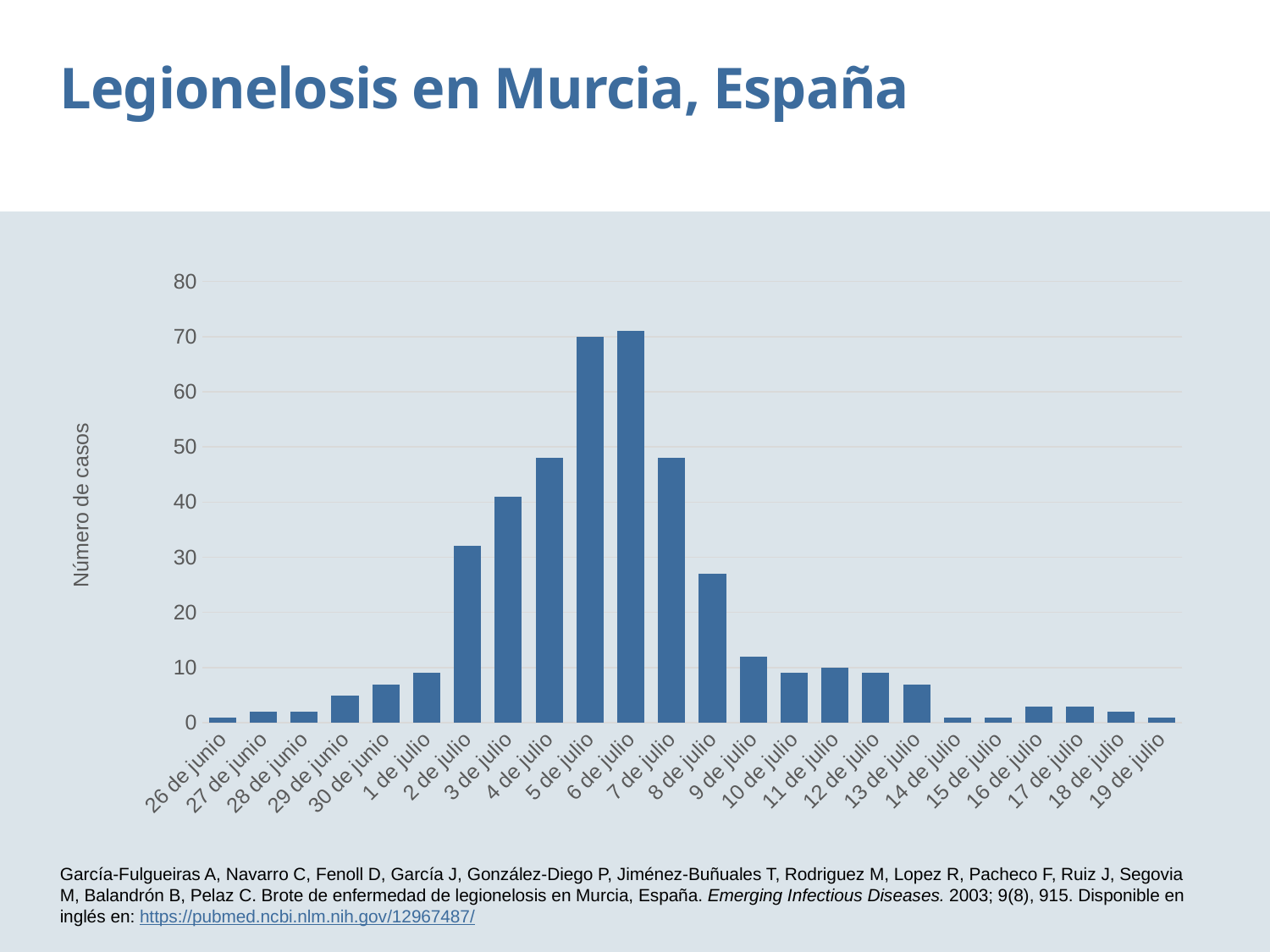
Is the value for 29 de junio greater or less than 10? less Is the value for 2 de julio greater or less than 30? greater What is the title of the slide containing the chart? Legionelosis en Murcia, España Is the value for 4 de julio greater or less than 40? greater What is the label of the vertical axis? Número de casos Which has more cases, 2 de julio or 8 de julio? 2 de julio How many dates are shown along the x axis of the chart? 24 From 6 de julio to 13 de julio, do the values rise or fall? fall Which has more cases, 3 de julio or 7 de julio? 7 de julio What kind of chart is shown on the slide? bar chart